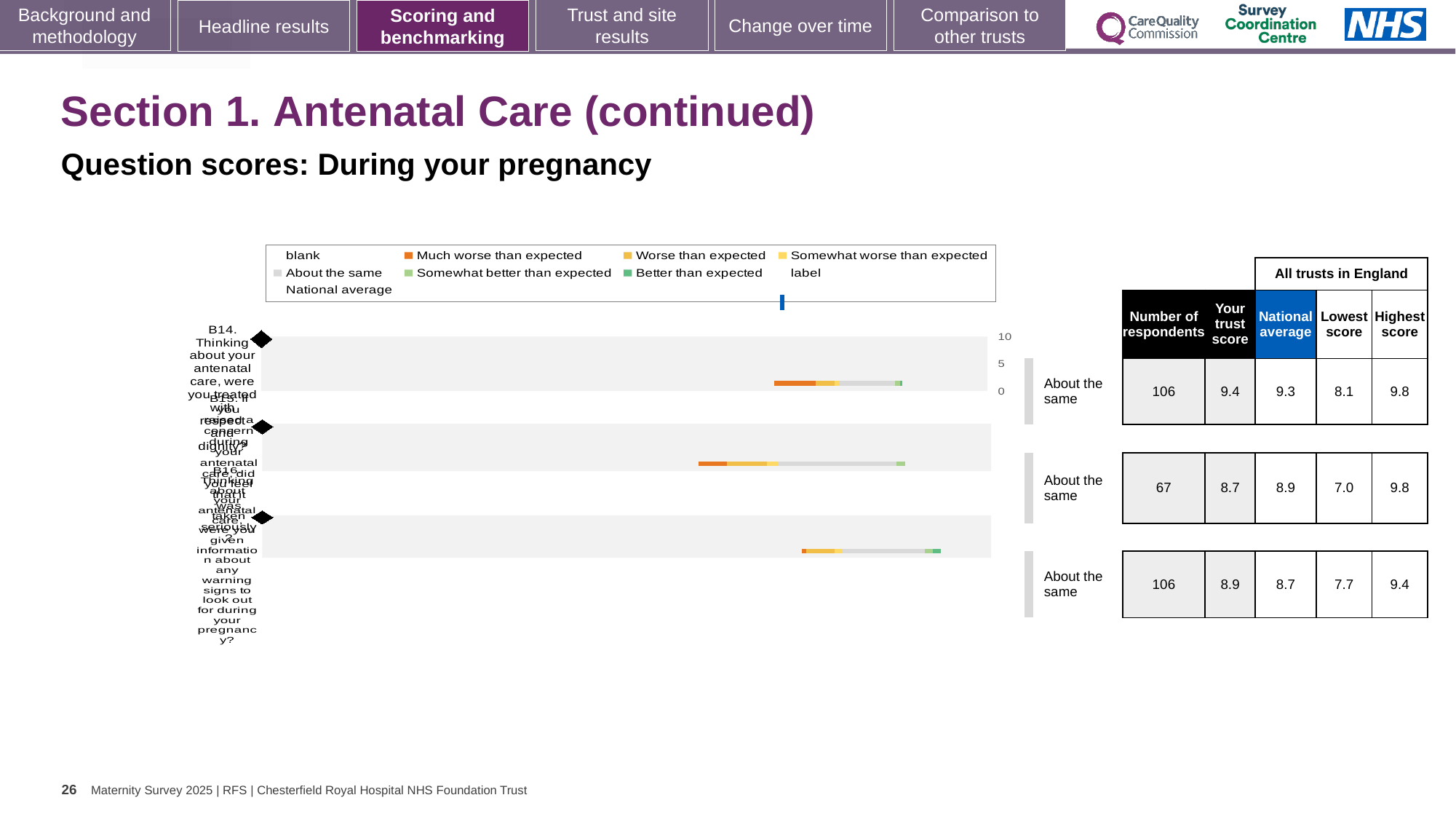
How many question bars are plotted in the chart? 3 In the table beside the chart, what is the national average for the third question (B16)? 8.7 In the table beside the chart, what is the number of respondents for the first question (B14)? 106 What is the heading above the chart? Question scores: During your pregnancy For the first question (B14), which is larger: the trust score or the national average? trust score (9.4) Which question has the highest trust score in the table? B14 (9.4) What kind of chart is shown on the slide? bar chart For the third question (B16), what is the difference between the highest score and the lowest score in the table? 1.7 What colour does the legend use for 'Much worse than expected'? orange What benchmark category is shown for the second question (B15)? About the same Which question has the lowest number of respondents in the table? B15 (67) In the table beside the chart, what is the trust score for the second question (B15)? 8.7